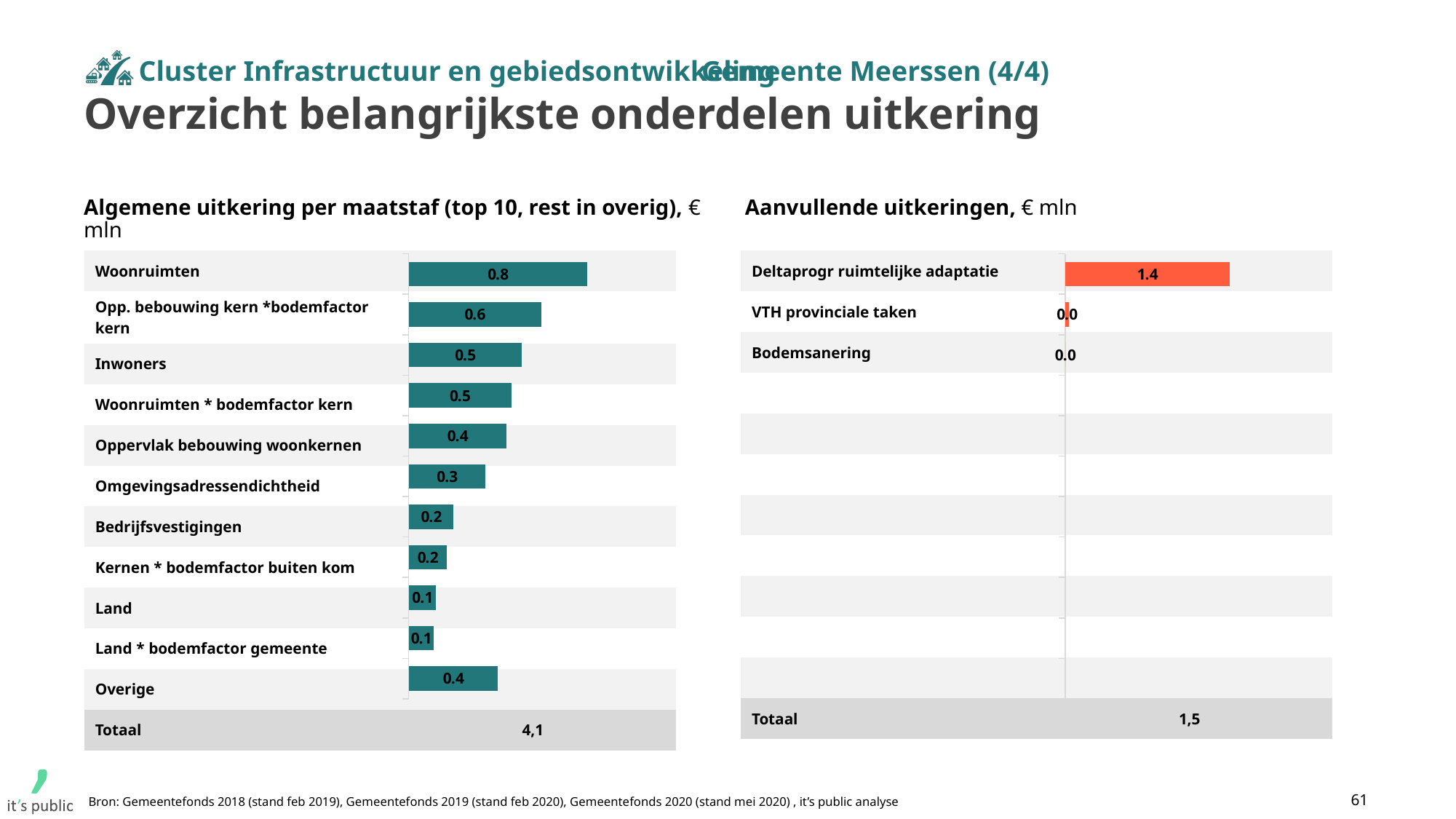
In the 'Aanvullende uitkeringen' chart, what is the value for Bodemsanering? 0.0 In the 'Algemene uitkering per maatstaf' chart, which is larger: Inwoners or Oppervlak bebouwing woonkernen? Inwoners In the 'Algemene uitkering per maatstaf' chart, what is the difference between Woonruimten and Bedrijfsvestigingen? 0.6 In the 'Algemene uitkering per maatstaf' chart, what is the value for Overige? 0.4 In the 'Algemene uitkering per maatstaf' chart, what is the value for Woonruimten? 0.8 In the 'Algemene uitkering per maatstaf' chart, what is the value for Omgevingsadressendichtheid? 0.3 What kind of chart is the 'Aanvullende uitkeringen' chart? Bar chart What is the total shown for the 'Algemene uitkering per maatstaf' chart? 4,1 How many categories are shown in the 'Algemene uitkering per maatstaf' chart? 11 In the 'Algemene uitkering per maatstaf' chart, which category has the highest value? Woonruimten In the 'Aanvullende uitkeringen' chart, what is the value for Deltaprogr ruimtelijke adaptatie? 1.4 What is the total shown for the 'Aanvullende uitkeringen' chart? 1,5